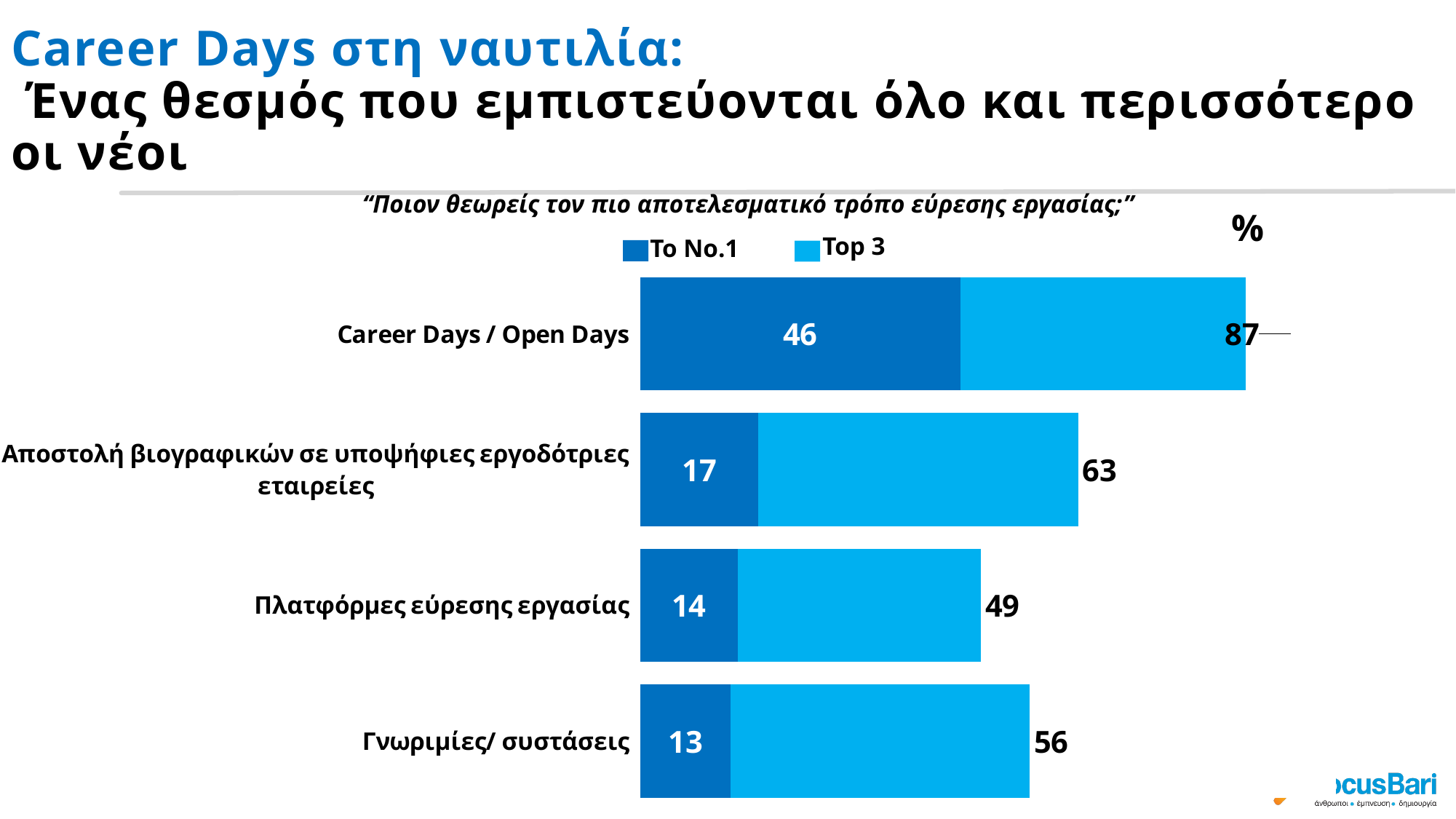
What is the 'Top 3' value shown for Γνωριμίες/ συστάσεις? 56 Which category has the lowest 'Το No.1' value? Γνωριμίες/ συστάσεις What kind of chart is shown on the slide? bar chart What are the two legend entries of the chart? Το No.1 and Top 3 What is the 'Το No.1' value for Career Days / Open Days? 46 What is the 'Top 3' value shown for Career Days / Open Days? 87 Which category has the highest 'Το No.1' value? Career Days / Open Days What is the 'Το No.1' value for Πλατφόρμες εύρεσης εργασίας? 14 What is the difference between the 'Το No.1' values for Career Days / Open Days and Αποστολή βιογραφικών σε υποψήφιες εργοδότριες εταιρείες? 29 Which has the larger 'Top 3' value: Αποστολή βιογραφικών σε υποψήφιες εργοδότριες εταιρείες or Γνωριμίες/ συστάσεις? Αποστολή βιογραφικών σε υποψήφιες εργοδότριες εταιρείες How many categories are plotted in the chart? 4 How many series does the chart legend list? 2